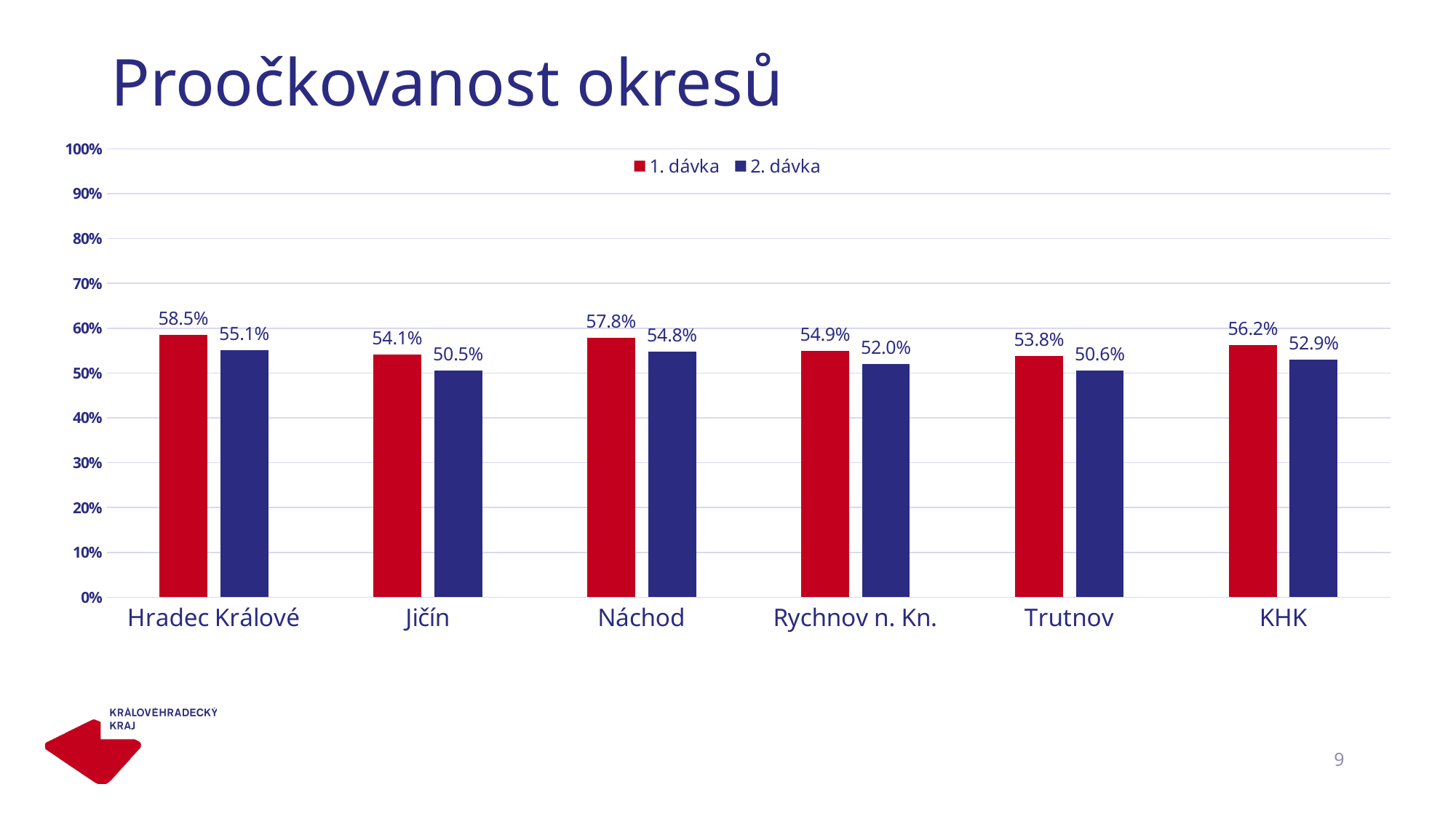
Which is larger: 1. dávka for Trutnov or 1. dávka for Rychnov n. Kn.? Rychnov n. Kn. How many categories are shown on the x axis? 6 Which category has the highest value for 1. dávka? Hradec Králové Is the value of 2. dávka for Trutnov greater or less than 60%? less What kind of chart is shown on the slide? bar chart What is the value of 2. dávka for KHK? 52.9% What is the difference between 1. dávka and 2. dávka for Náchod? 3.0% How many series does the legend list? 2 Which category has the lowest value for 2. dávka? Jičín What is the title of the slide? Proočkovanost okresů What is the value of 2. dávka for Jičín? 50.5% What is the value of 1. dávka for Hradec Králové? 58.5%